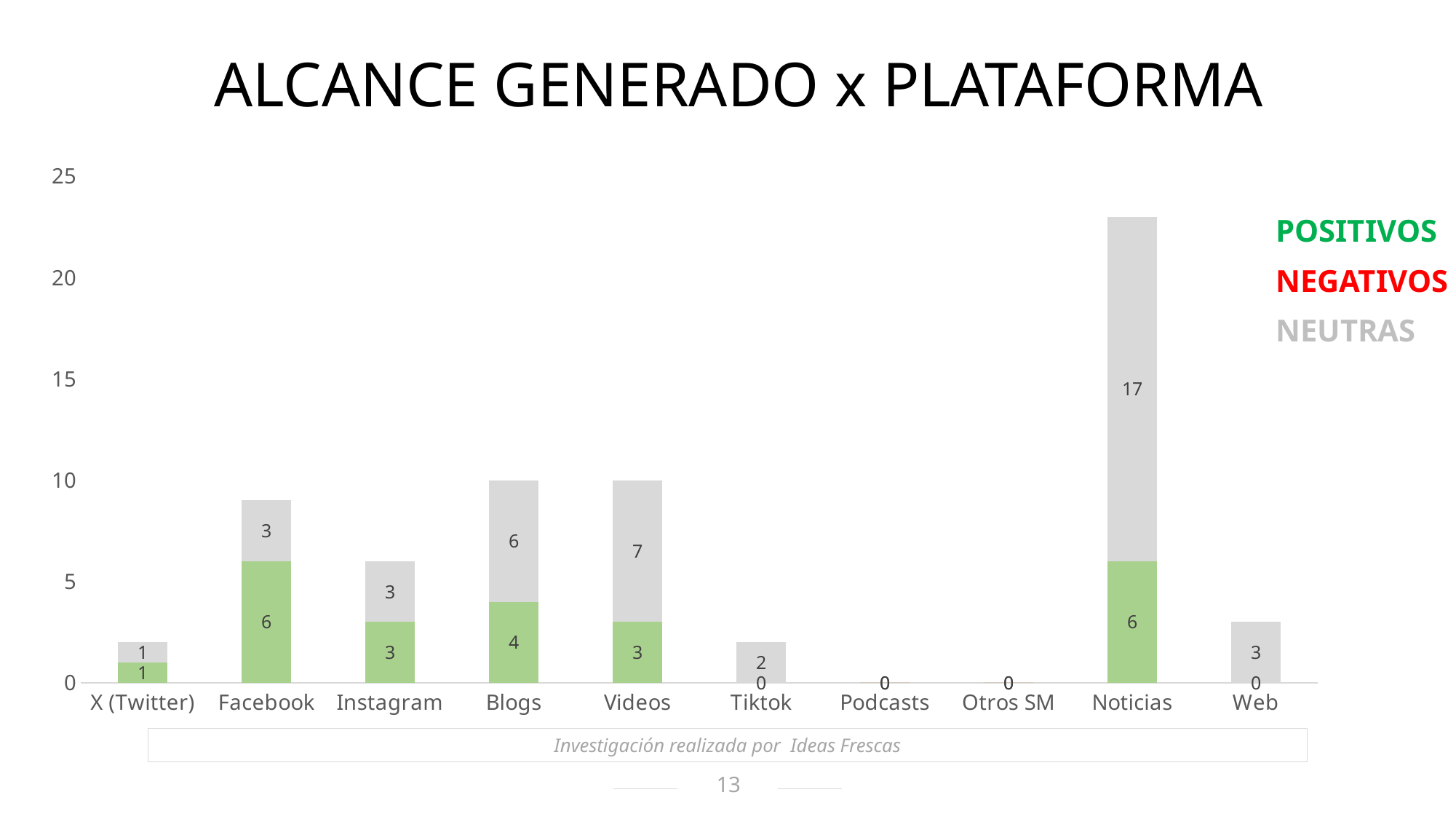
What is the value of the grey (neutras) segment for Videos? 7 How many platform categories are shown on the x axis? 10 What is the title of the chart? ALCANCE GENERADO x PLATAFORMA Which is larger, the green (positivos) value for Facebook or for Instagram? Facebook What type of chart is shown on the slide? Stacked bar chart What is the difference between the grey (neutras) values for Noticias and Videos? 10 Which platform has the tallest stacked bar? Noticias What is the total of the stacked bar for Noticias? 23 What is the total of the stacked bar for Blogs? 10 What is the value of the green (positivos) segment for Facebook? 6 What is the value of the grey (neutras) segment for Noticias? 17 What is the value of the green (positivos) segment for Blogs? 4